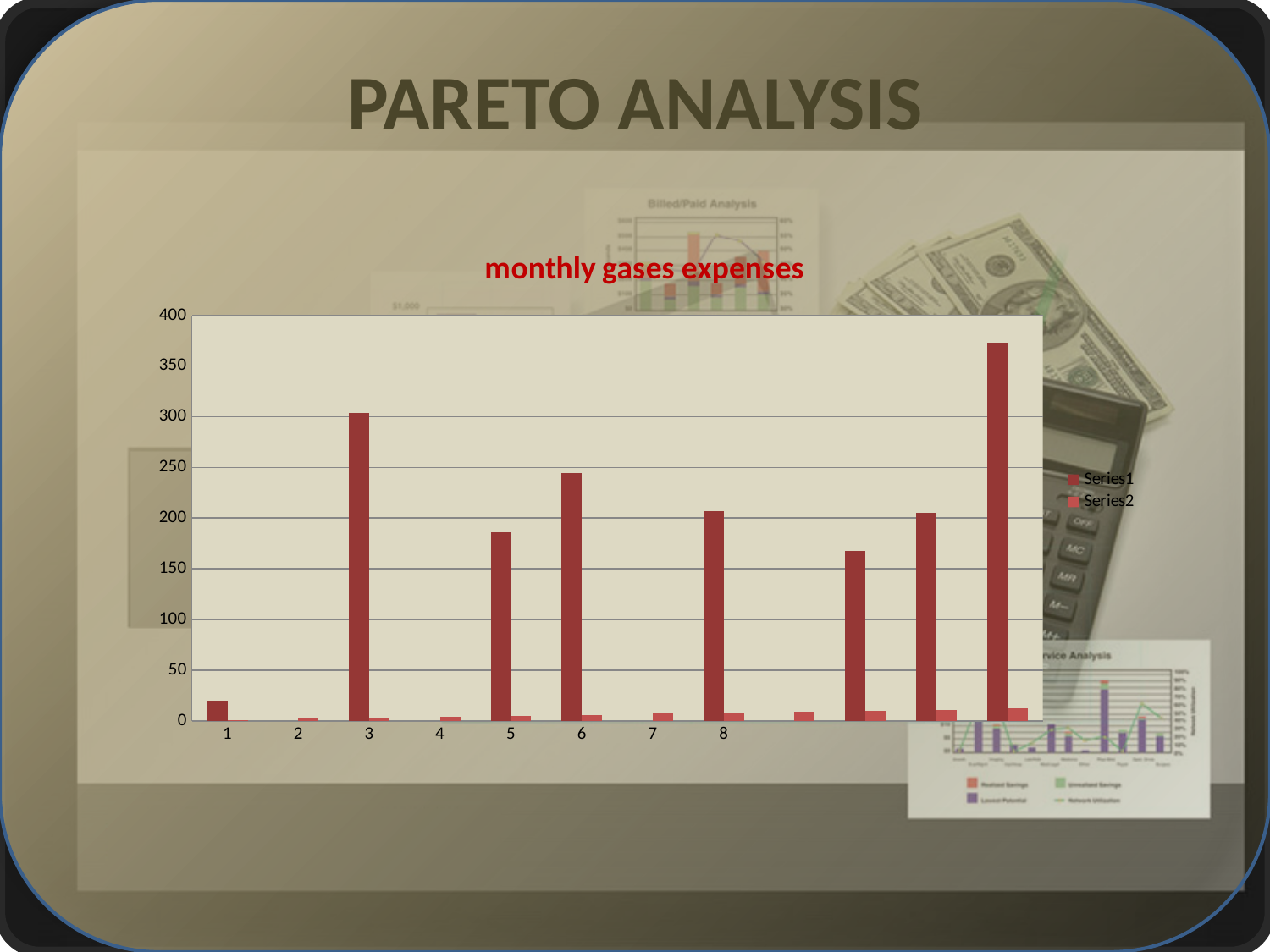
What are the two entries in the chart's legend? Series1 and Series2 What kind of chart is shown on the slide? bar chart What is the title of the chart? monthly gases expenses Which has the larger Series1 value, category 5 or category 6? category 6 Is the Series1 value for category 8 greater or less than 150? greater How many series does the chart's legend list? 2 Which has the larger Series1 value, category 3 or category 6? category 3 Is the Series1 value for category 6 greater or less than 200? greater Is the Series1 value for category 1 greater or less than 50? less Among categories 1 through 8, which category has the highest Series1 value? 3